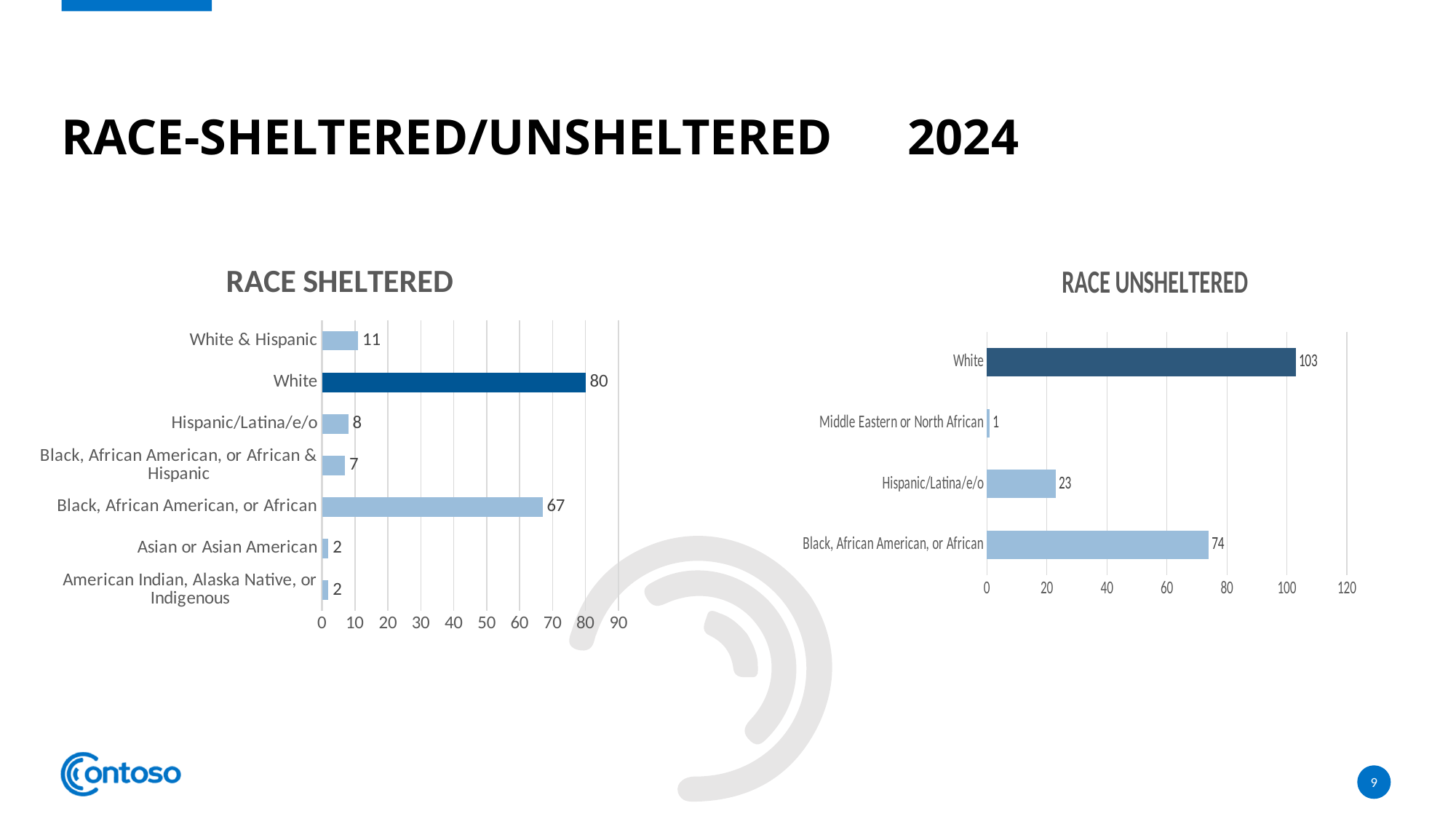
In the RACE SHELTERED chart, what is the value for White? 80 How many categories are shown in the RACE UNSHELTERED chart? 4 In the RACE SHELTERED chart, what is the difference between the values for White & Hispanic and Hispanic/Latina/e/o? 3 In the RACE UNSHELTERED chart, what is the value for Middle Eastern or North African? 1 In the RACE UNSHELTERED chart, which category has the lowest value? Middle Eastern or North African In the RACE SHELTERED chart, which is larger: the value for White & Hispanic or the value for Black, African American, or African & Hispanic? White & Hispanic What kind of chart is the RACE UNSHELTERED chart? Bar chart In the RACE UNSHELTERED chart, what is the difference between the values for White and Black, African American, or African? 29 In the RACE SHELTERED chart, what is the value for Black, African American, or African? 67 In the RACE UNSHELTERED chart, what is the value for Hispanic/Latina/e/o? 23 How many categories are shown in the RACE SHELTERED chart? 7 In the RACE SHELTERED chart, which category has the highest value? White